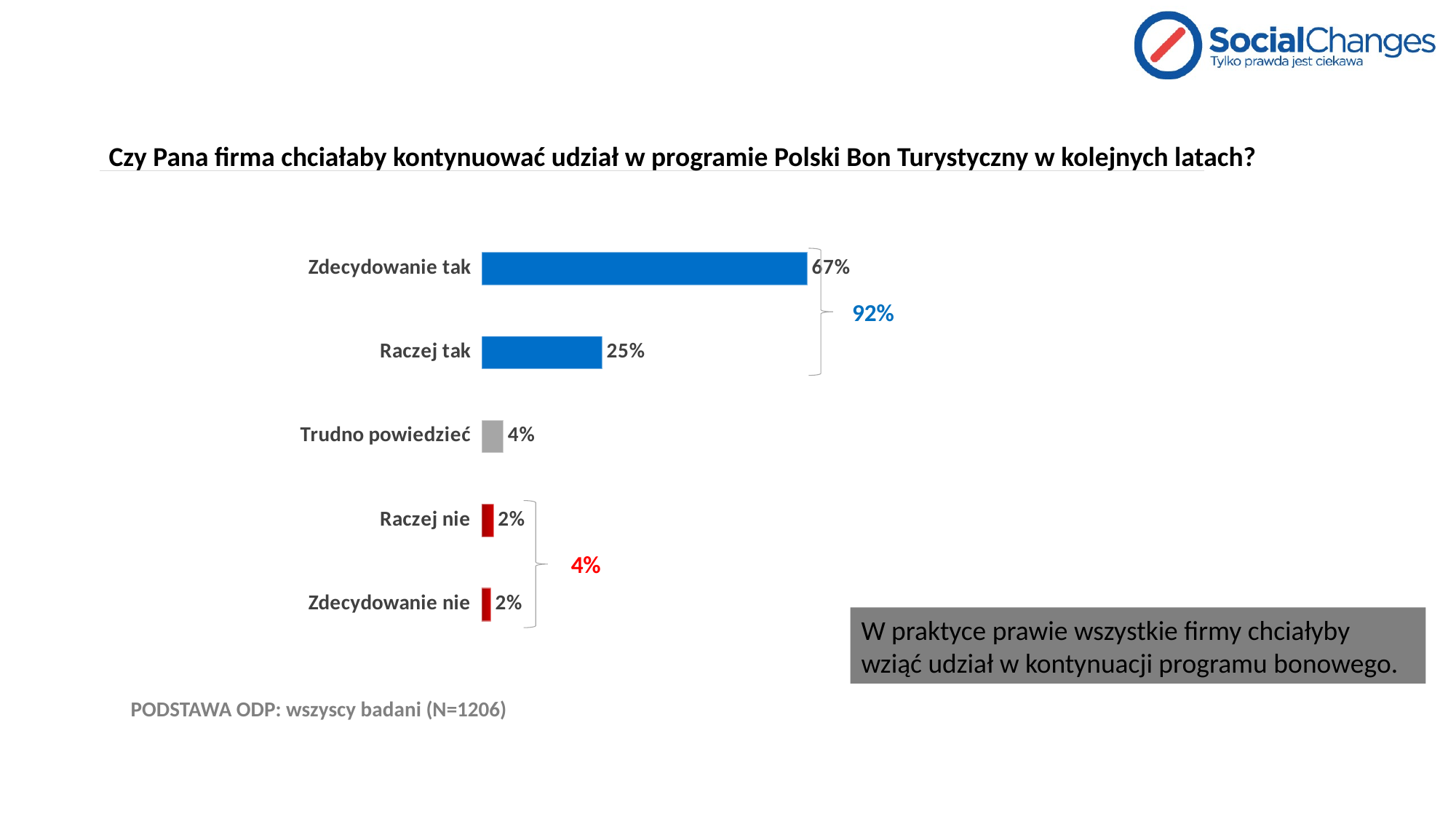
What colour are the bars for Raczej nie and Zdecydowanie nie? Red What is the value for Zdecydowanie tak? 67% How many categories are shown in the chart? 5 Which category has the highest value? Zdecydowanie tak What is the difference between the values for Zdecydowanie tak and Raczej tak? 42% What is the value for Raczej nie? 2% Which is larger, the value for Raczej tak or the value for Trudno powiedzieć? Raczej tak What combined percentage is shown for Zdecydowanie tak and Raczej tak together? 92% What kind of chart is shown on the slide? Bar chart What is the value for Raczej tak? 25% What is the value for Trudno powiedzieć? 4% What combined percentage is shown for Raczej nie and Zdecydowanie nie together? 4%